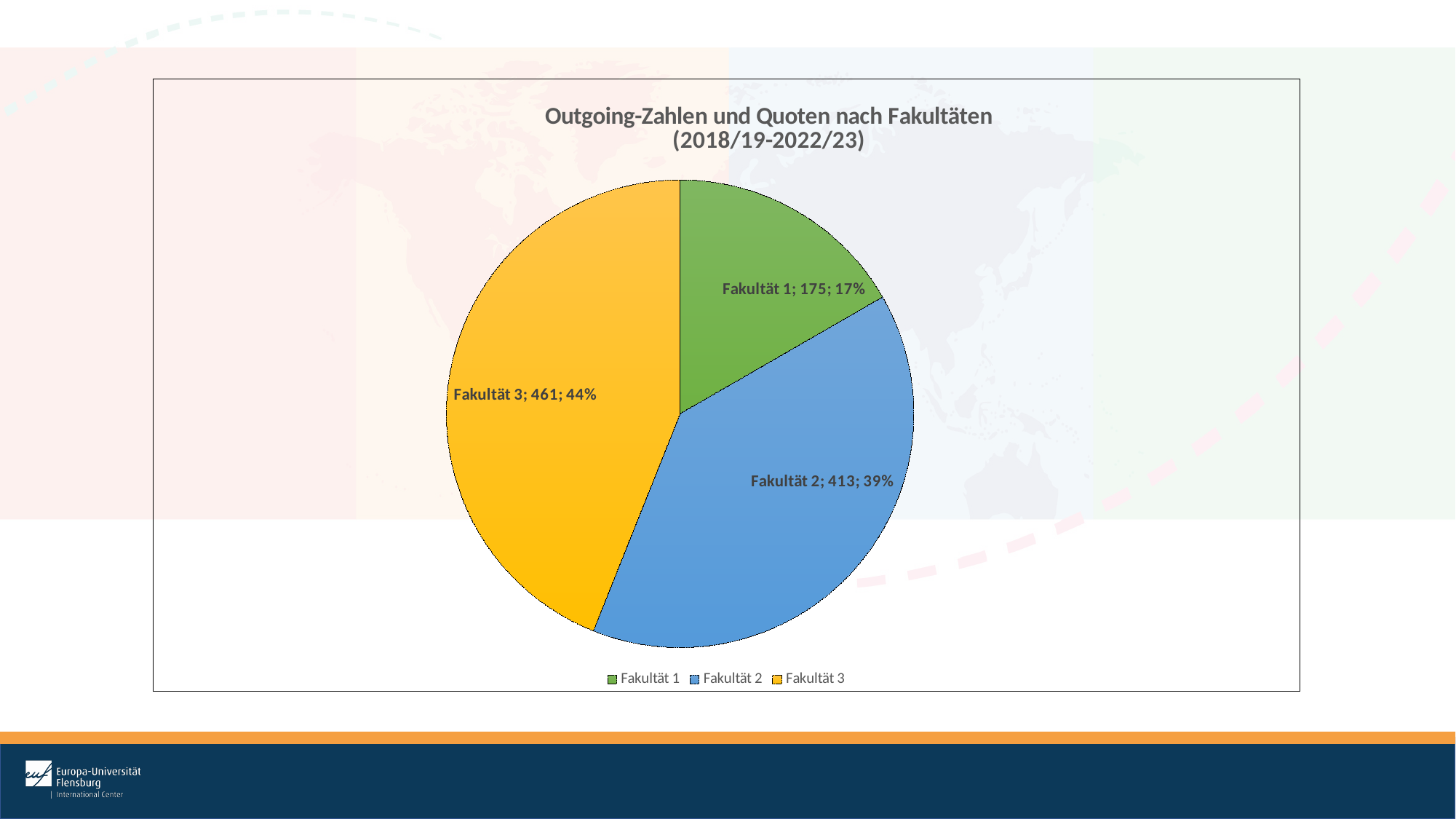
What is the value for Fakultät 3? 461 What is the value for Fakultät 1? 175 What is the difference between the values for Fakultät 3 and Fakultät 2? 48 What share of the pie does Fakultät 1 represent? 17% Which Fakultät has the smallest slice? Fakultät 1 What type of chart is shown on the slide? pie chart Which colour represents Fakultät 2 in the legend? blue Which Fakultät has the largest slice? Fakultät 3 What is the title of the chart? Outgoing-Zahlen und Quoten nach Fakultäten (2018/19-2022/23) What share of the pie does Fakultät 3 represent? 44% What is the value for Fakultät 2? 413 How many slices does the pie chart have? 3